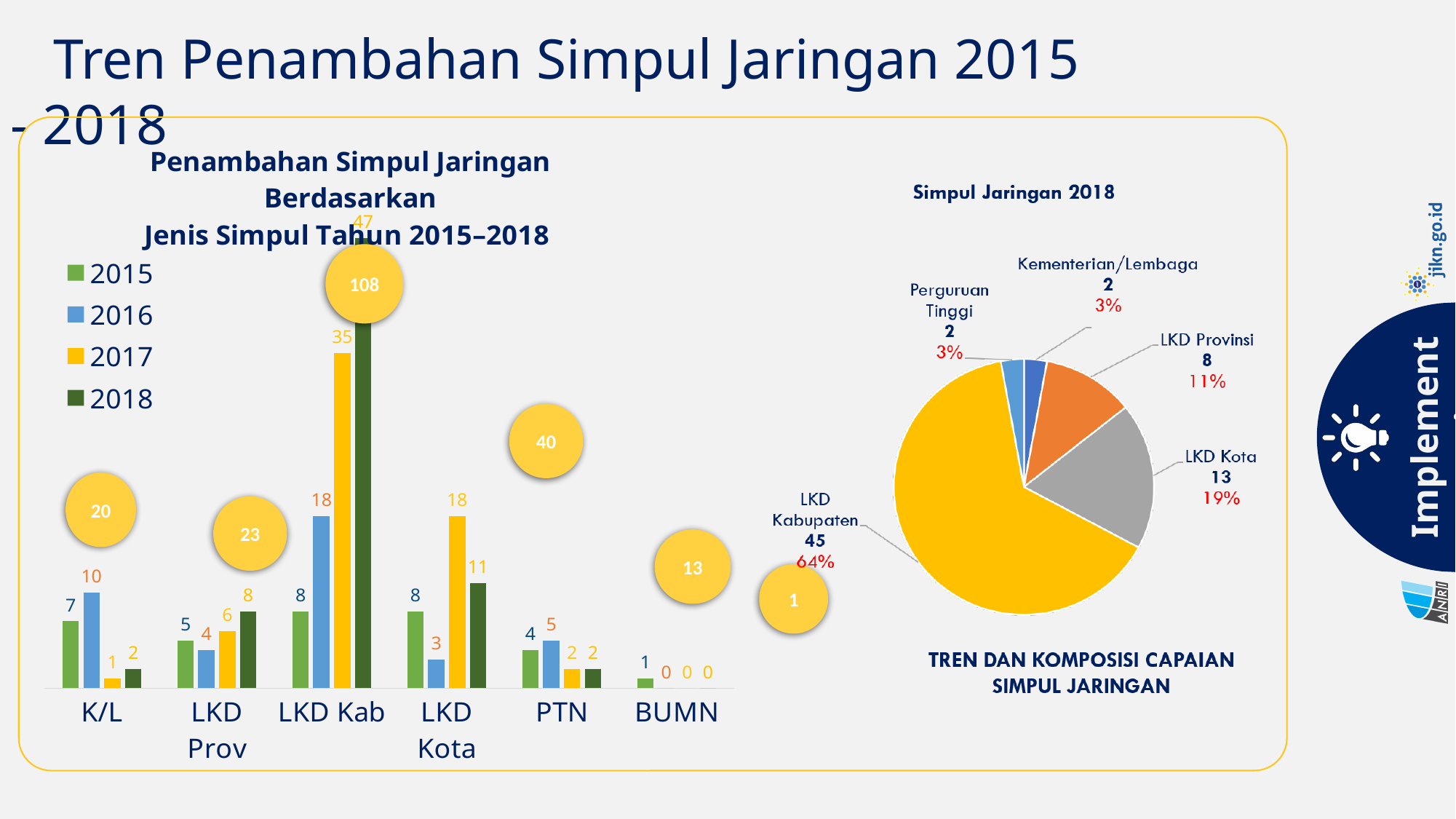
In the bar chart 'Penambahan Simpul Jaringan Berdasarkan Jenis Simpul Tahun 2015–2018', which is larger for LKD Kota: the 2017 value or the 2018 value? 2017 In the bar chart 'Penambahan Simpul Jaringan Berdasarkan Jenis Simpul Tahun 2015–2018', which category has the highest value in 2018? LKD Kab In the bar chart 'Penambahan Simpul Jaringan Berdasarkan Jenis Simpul Tahun 2015–2018', which category has the lowest value in 2015? BUMN How many categories are shown on the x axis of the bar chart 'Penambahan Simpul Jaringan Berdasarkan Jenis Simpul Tahun 2015–2018'? 6 In the pie chart 'Simpul Jaringan 2018', what share does LKD Kabupaten have? 64% In the bar chart 'Penambahan Simpul Jaringan Berdasarkan Jenis Simpul Tahun 2015–2018', what is the value for K/L in 2016? 10 In the bar chart 'Penambahan Simpul Jaringan Berdasarkan Jenis Simpul Tahun 2015–2018', do the values for LKD Kab rise or fall from 2015 to 2018? rise How many series does the legend of the bar chart 'Penambahan Simpul Jaringan Berdasarkan Jenis Simpul Tahun 2015–2018' list? 4 In the bar chart 'Penambahan Simpul Jaringan Berdasarkan Jenis Simpul Tahun 2015–2018', what is the difference between the 2018 and 2017 values for LKD Kab? 12 In the pie chart 'Simpul Jaringan 2018', what is the value for LKD Kota? 13 In the bar chart 'Penambahan Simpul Jaringan Berdasarkan Jenis Simpul Tahun 2015–2018', what is the value for LKD Kab in 2017? 35 What kind of chart is 'Simpul Jaringan 2018'? pie chart